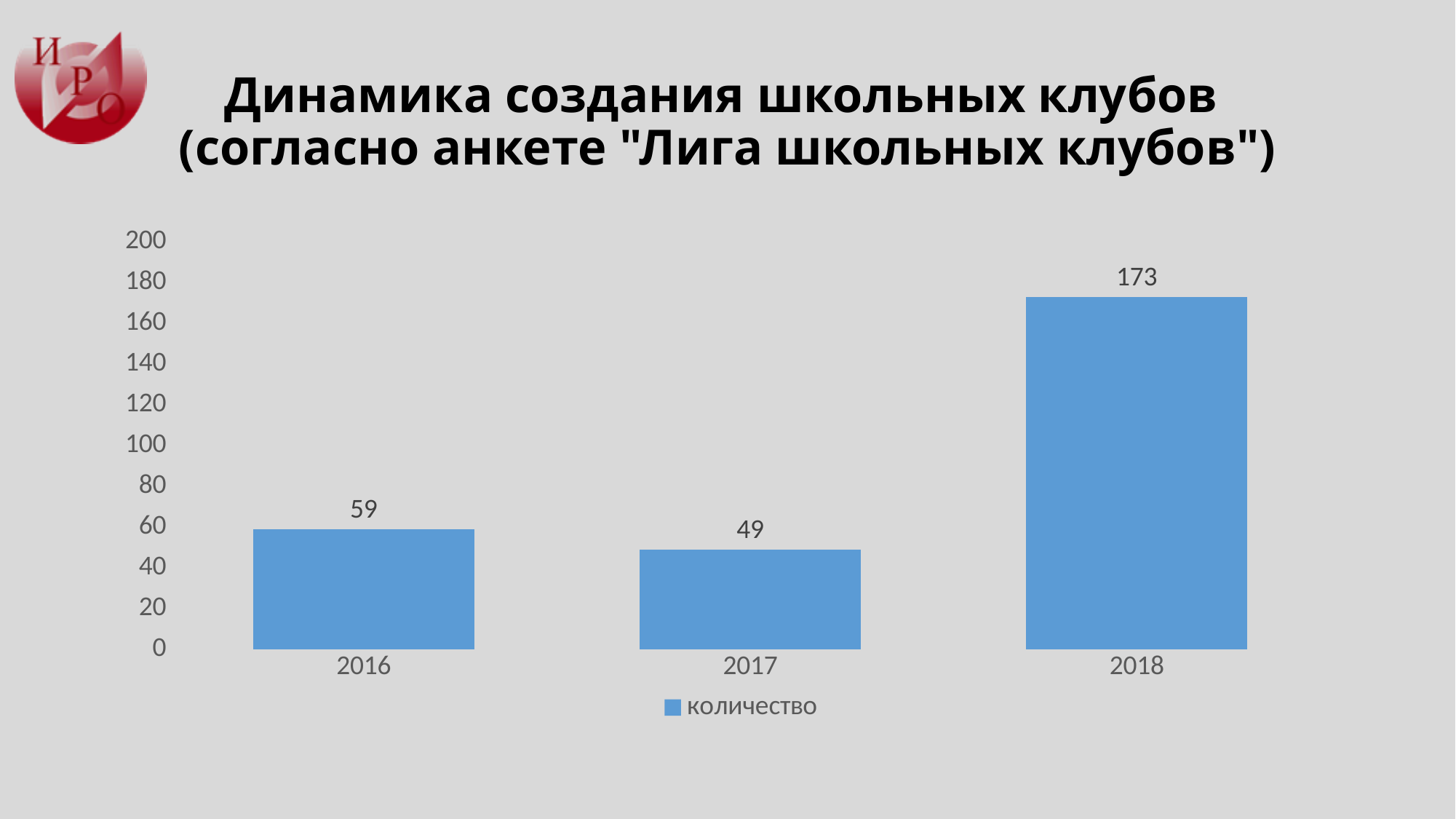
What is the difference between the values for 2018 and 2017? 124 Which year has the lowest value? 2017 Which is larger, the value for 2016 or the value for 2017? 2016 How many years are shown on the x axis? 3 What is the difference between the values for 2016 and 2017? 10 What is the name of the series listed in the legend? количество Is the value for 2018 greater or less than 160? greater What is the value for 2017? 49 What is the value for 2016? 59 What kind of chart is shown on the slide? bar chart What is the value for 2018? 173 Which year has the highest value? 2018